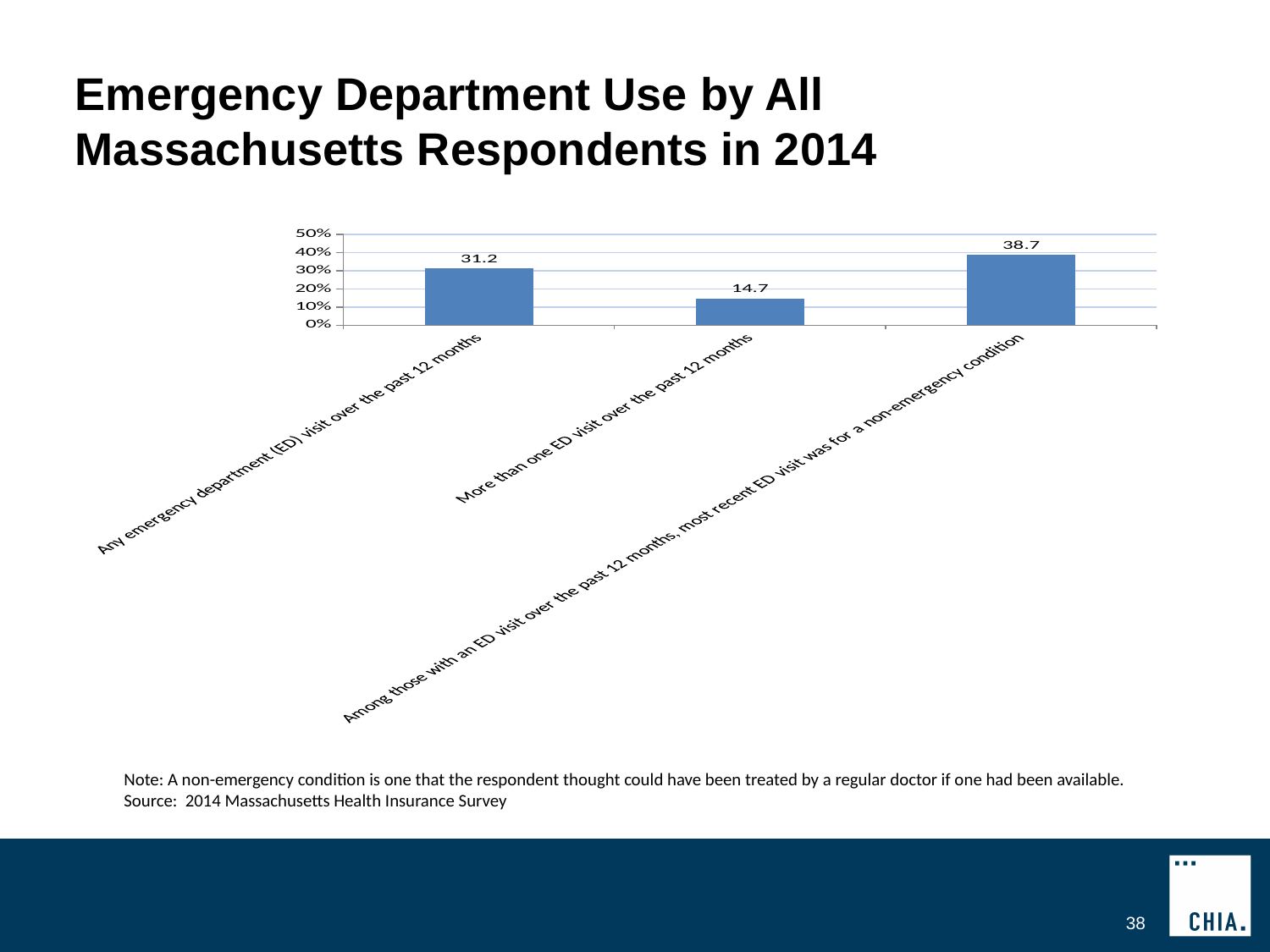
What is the maximum value shown on the y axis? 50% What is the value for 'Among those with an ED visit over the past 12 months, most recent ED visit was for a non-emergency condition'? 38.7 Which is larger: the value for 'Any emergency department (ED) visit over the past 12 months' or the value for the non-emergency condition category? The non-emergency condition category Which category has the lowest value? More than one ED visit over the past 12 months What kind of chart is shown on the slide? Bar chart What is the difference between the highest and lowest values on the chart? 24 Is the value for 'More than one ED visit over the past 12 months' greater or less than 20%? less Which category has the highest value? Among those with an ED visit over the past 12 months, most recent ED visit was for a non-emergency condition What is the value for 'More than one ED visit over the past 12 months'? 14.7 What is the difference between the value for 'Any emergency department (ED) visit over the past 12 months' and 'More than one ED visit over the past 12 months'? 16.5 How many categories are shown on the chart? 3 What is the value for 'Any emergency department (ED) visit over the past 12 months'? 31.2